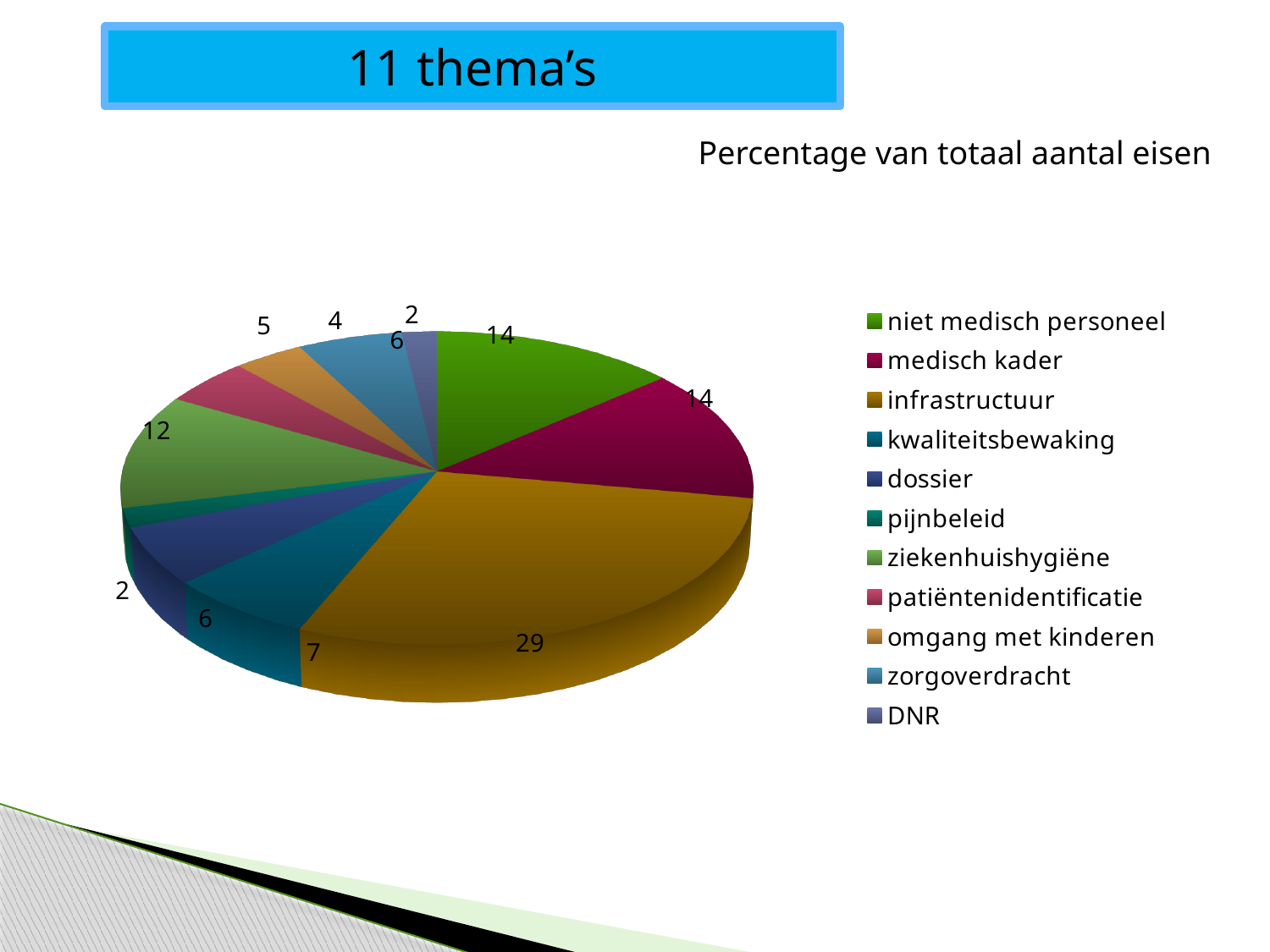
What is the value shown for kwaliteitsbewaking? 7 What type of chart is shown on the slide? pie chart What is the title of the chart? Percentage van totaal aantal eisen What is the difference between the values for dossier and omgang met kinderen? 2 Which category has the largest slice of the pie? infrastructuur What is the difference between the values for infrastructuur and niet medisch personeel? 15 What is the value shown for medisch kader? 14 What is the value shown for infrastructuur? 29 What is the value shown for ziekenhuishygiëne? 12 What is the value shown for DNR? 2 Which is larger, the value for ziekenhuishygiëne or the value for kwaliteitsbewaking? ziekenhuishygiëne How many categories does the legend of the pie chart list? 11